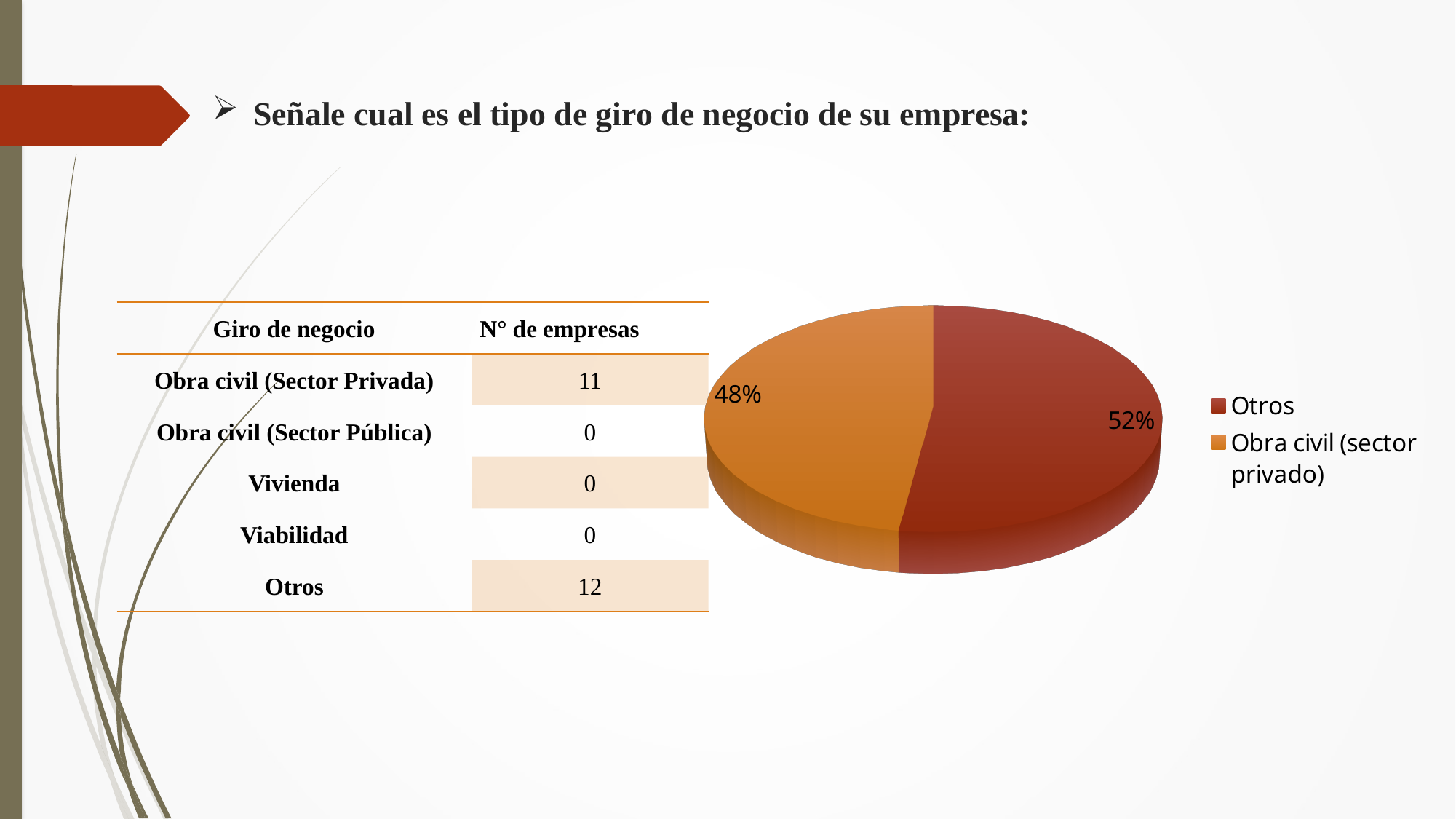
What kind of chart is shown on the slide? pie chart How many entries does the legend of the pie chart list? 2 Which slice of the pie is the largest? Otros What colour is the Obra civil (sector privado) slice in the pie chart? orange What share of the pie does the Otros slice represent? 52% What is the difference in percentage points between the Otros slice and the Obra civil (sector privado) slice? 4% What colour is the Otros slice in the pie chart? dark red Which is larger in the pie chart: Otros or Obra civil (sector privado)? Otros How many slices does the pie chart have? 2 What share of the pie does the Obra civil (sector privado) slice represent? 48% Which slice of the pie is the smallest? Obra civil (sector privado)